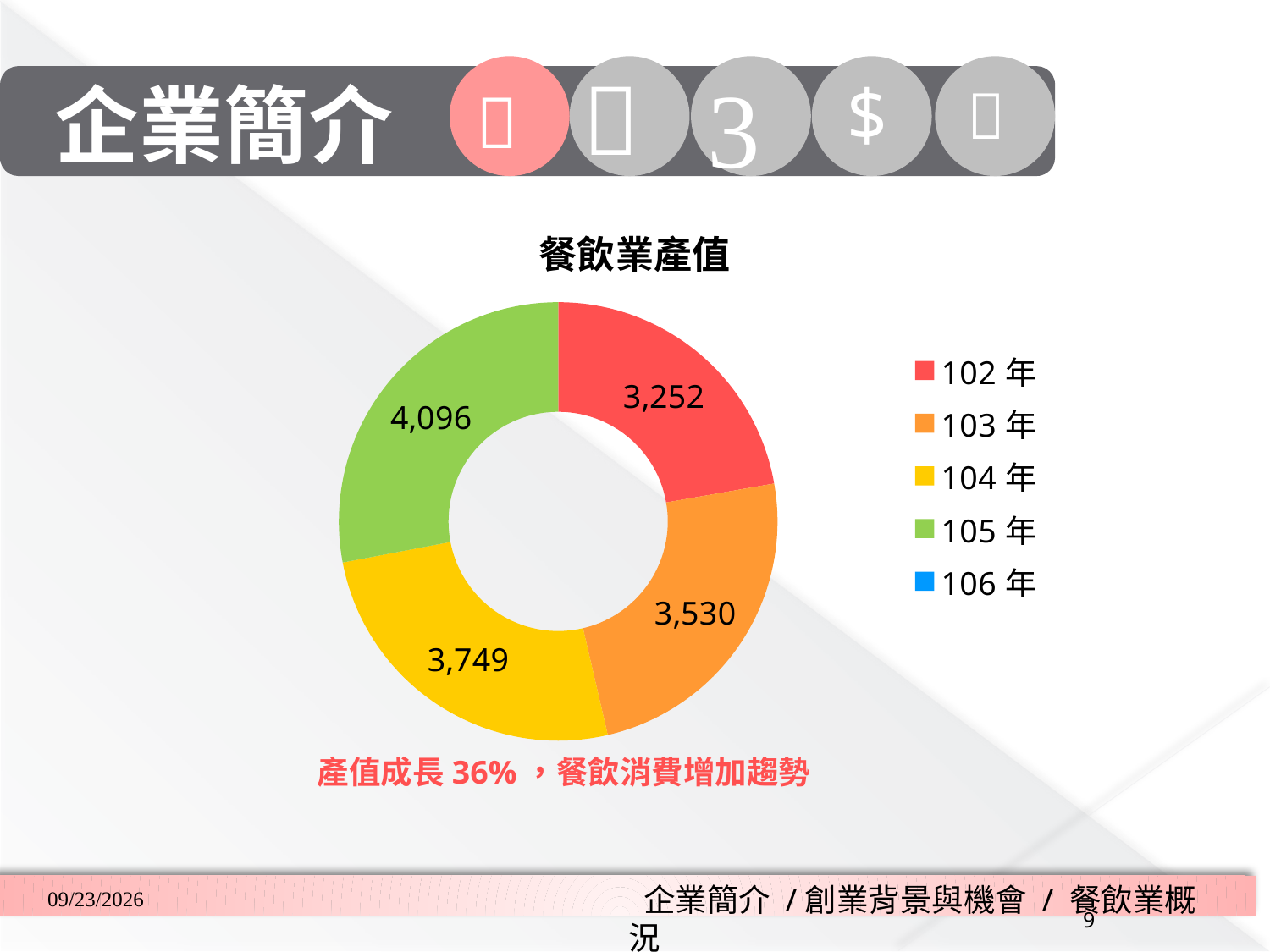
What is the value for 105 年? 4,096 How many entries does the legend list? 5 What is the value for 103 年? 3,530 Which year has the smallest slice in the chart? 102 年 What is the value for 102 年? 3,252 What is the value for 104 年? 3,749 How many slices with data labels are shown in the doughnut? 4 What is the difference between the values for 105 年 and 102 年? 844 What type of chart is shown on the slide? Doughnut (pie) chart Which year has the largest slice in the chart? 105 年 What is the title of the chart? 餐飲業產值 Which is larger, the value for 103 年 or the value for 104 年? 104 年